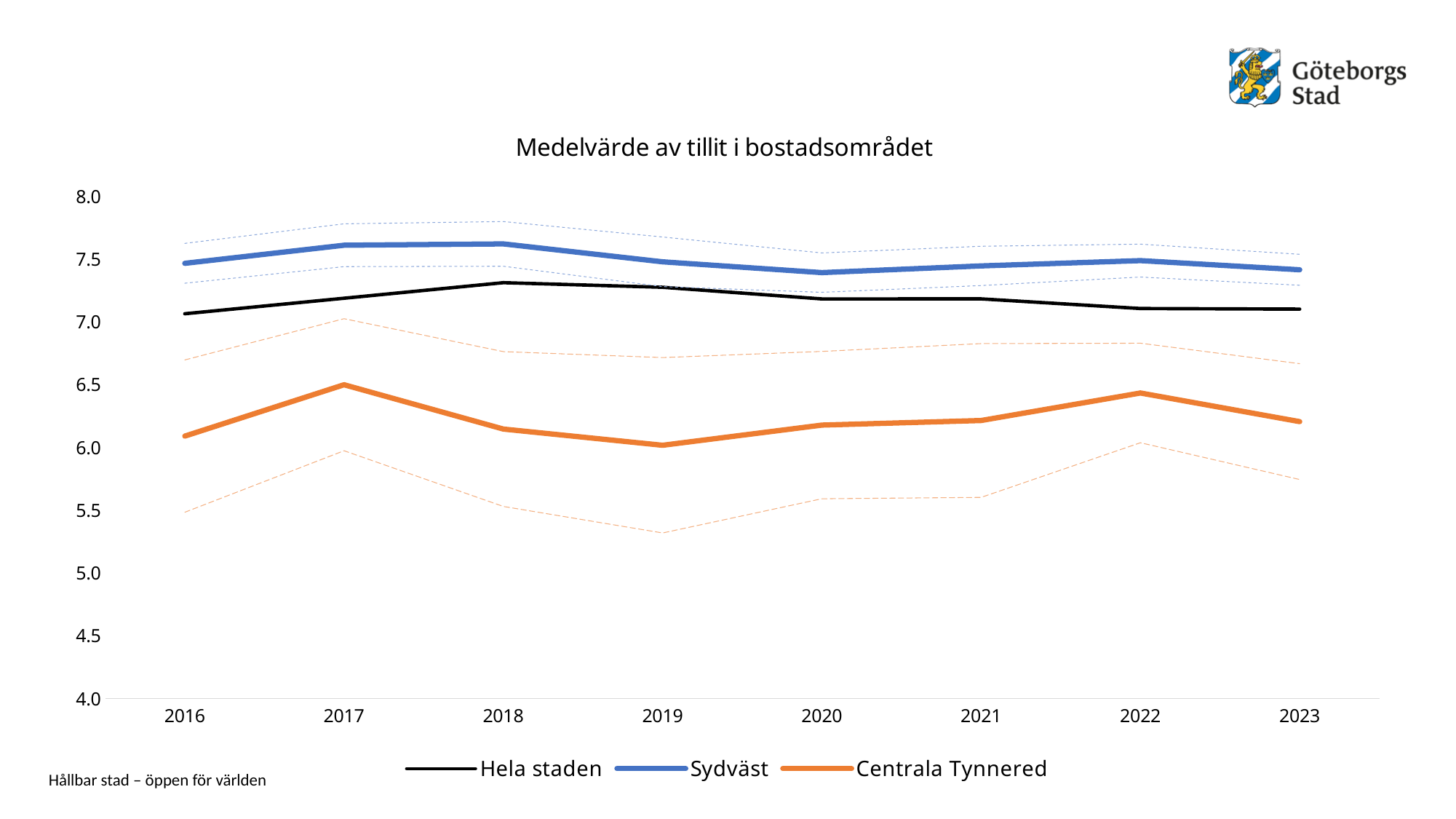
What kind of chart is shown on the slide? line chart How many years are shown on the x axis? 8 In 2020, which is larger: Sydväst or Centrala Tynnered? Sydväst How many series does the legend list? 3 What is the title of the chart? Medelvärde av tillit i bostadsområdet Is the value for Centrala Tynnered in 2019 greater or less than 6.5? less Is the value for Sydväst in 2018 greater or less than 7.5? greater Which series has the lowest values across all years? Centrala Tynnered Does the value for Centrala Tynnered rise or fall from 2016 to 2017? rise In which year is the value for Centrala Tynnered highest? 2017 Which series is drawn in orange? Centrala Tynnered Is the value for Hela staden in 2016 greater or less than 7.0? greater